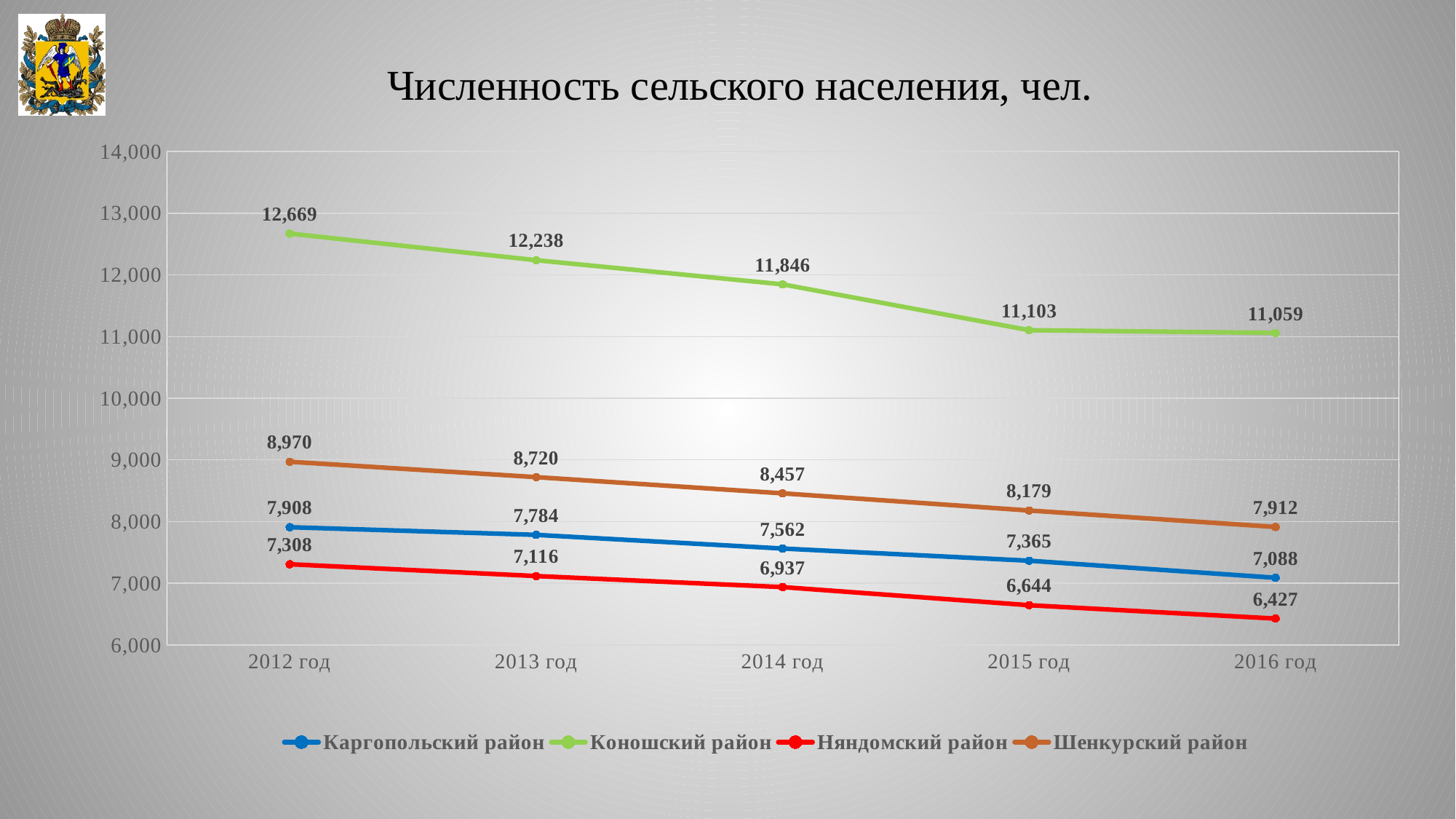
What is the difference between the Коношский район values in 2012 год and 2016 год? 1,610 What is the value for Няндомский район in 2016 год? 6,427 What is the value for Коношский район in 2012 год? 12,669 Which district has the lowest value in 2013 год? Няндомский район Which is larger: Шенкурский район in 2016 год or Каргопольский район in 2012 год? Шенкурский район in 2016 год How many series does the legend list? 4 What is the value for Шенкурский район in 2014 год? 8,457 What is the value for Каргопольский район in 2015 год? 7,365 Which district has the highest value in 2016 год? Коношский район Do the values for Няндомский район rise or fall from 2012 год to 2016 год? Fall What kind of chart is this? Line chart How many years are shown on the x axis? 5